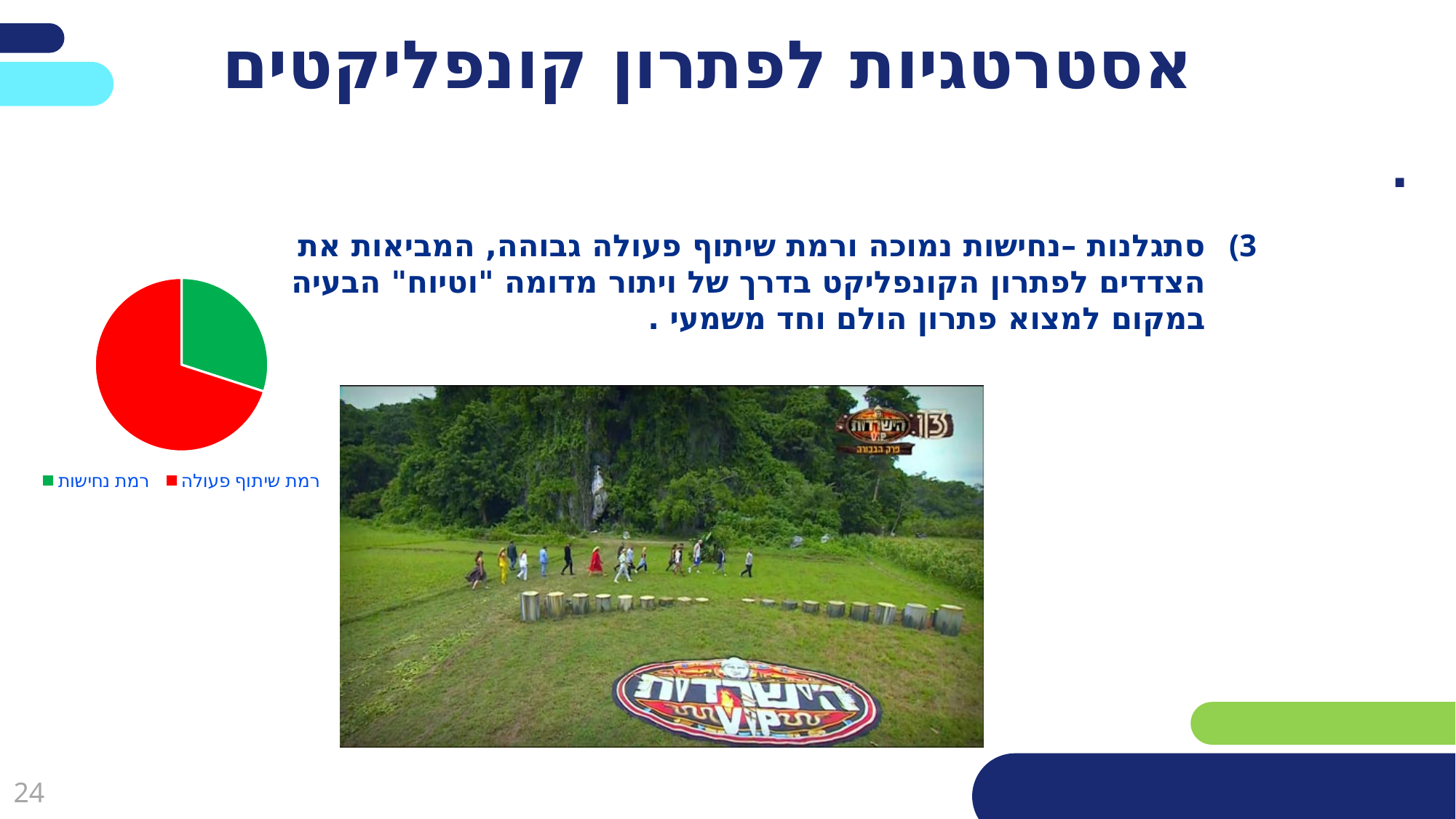
What colour is the רמת שיתוף פעולה slice in the pie chart? red What colour is the רמת נחישות slice in the pie chart? green Which slice of the pie chart is the largest? רמת שיתוף פעולה Which slice of the pie chart is the smallest? רמת נחישות How many slices does the pie chart have? 2 Which is larger in the pie chart, רמת נחישות or רמת שיתוף פעולה? רמת שיתוף פעולה How many entries does the legend of the pie chart list? 2 What kind of chart is shown on the slide? pie chart